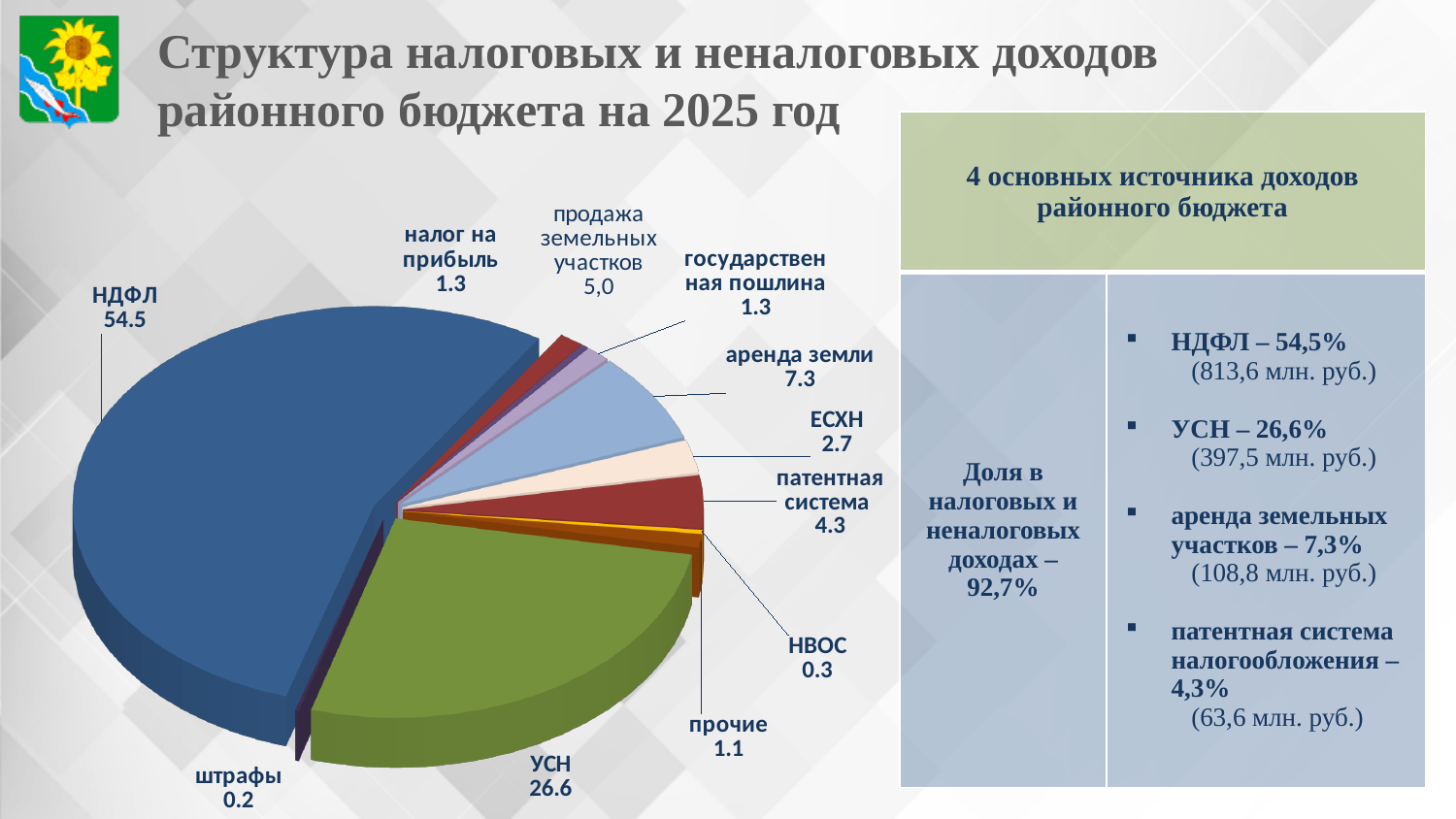
What type of chart is shown on the slide? pie chart What is the value shown for продажа земельных участков in the pie chart? 5,0 What is the difference between the values for НДФЛ and УСН in the pie chart? 27.9 Which category has the largest slice in the pie chart? НДФЛ What is the value shown for аренда земли in the pie chart? 7.3 What is the title of the slide containing the pie chart? Структура налоговых и неналоговых доходов районного бюджета на 2025 год What is the value shown for патентная система in the pie chart? 4.3 What is the value shown for НДФЛ in the pie chart? 54.5 How many categories are shown in the pie chart? 11 What is the value shown for УСН in the pie chart? 26.6 Which category has the smallest value in the pie chart? штрафы Which is larger in the pie chart: аренда земли or ЕСХН? аренда земли